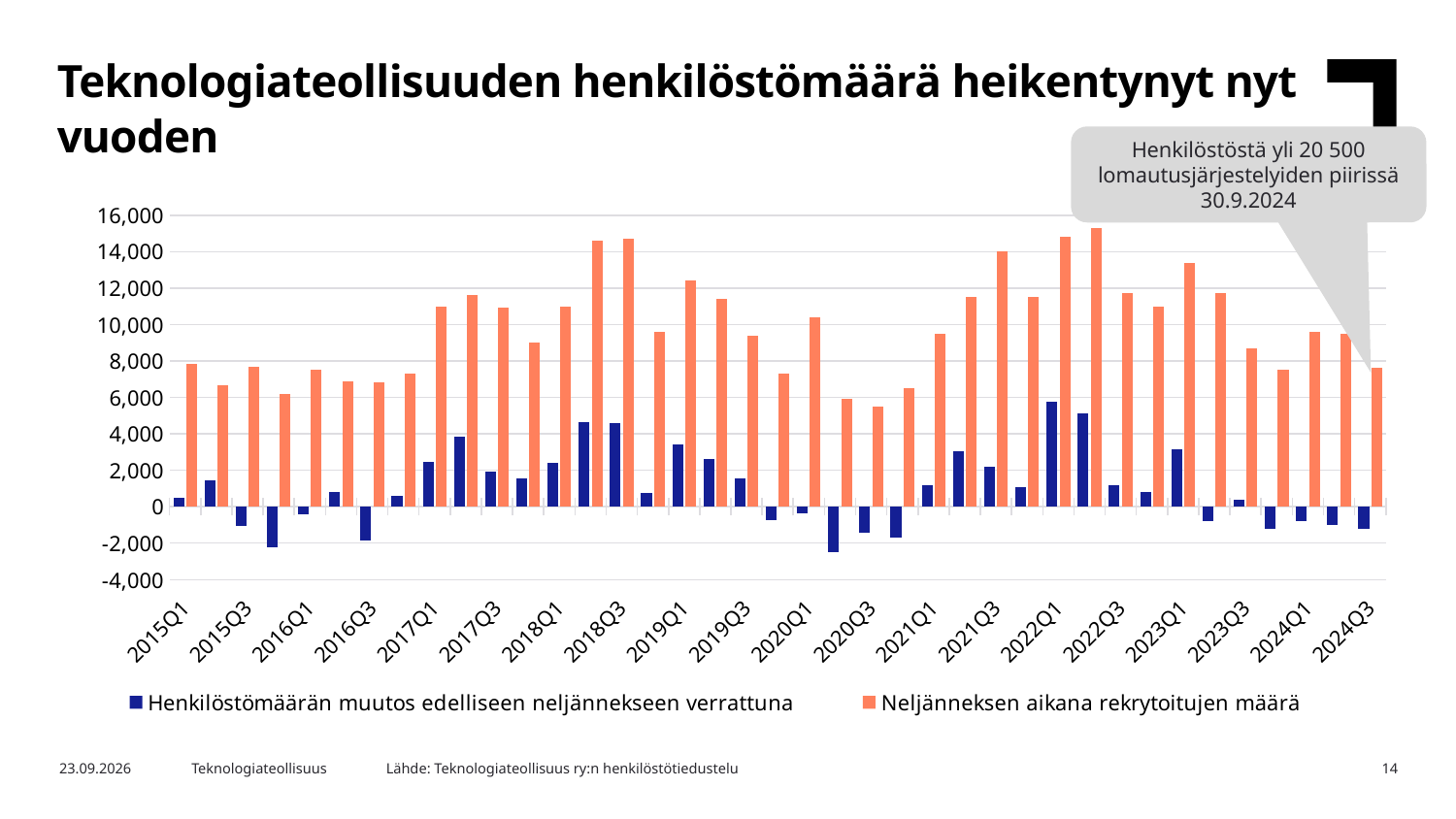
Is the value of 'Neljänneksen aikana rekrytoitujen määrä' for 2022Q1 greater or less than 14,000? greater What is the first category on the x axis of the chart? 2015Q1 Is the value of 'Henkilöstömäärän muutos edelliseen neljännekseen verrattuna' for 2024Q3 greater or less than 0? less What kind of chart is shown on the slide? Bar chart Is the value of 'Henkilöstömäärän muutos edelliseen neljännekseen verrattuna' for 2018Q3 greater or less than 4,000? greater What is the last category on the x axis of the chart? 2024Q3 How many series does the chart legend list? 2 Which is larger for 2024Q3: 'Neljänneksen aikana rekrytoitujen määrä' or 'Henkilöstömäärän muutos edelliseen neljännekseen verrattuna'? Neljänneksen aikana rekrytoitujen määrä